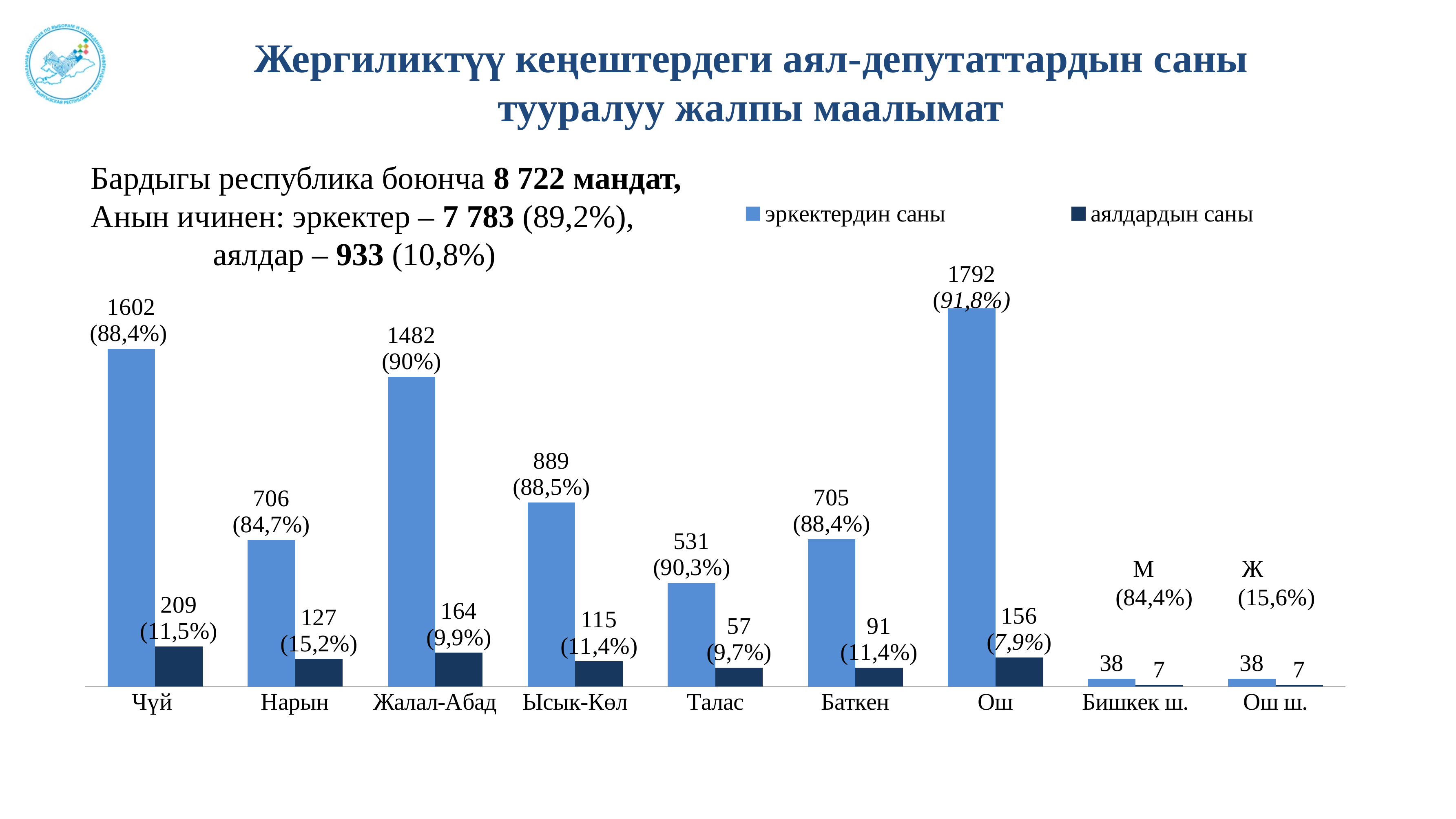
What percentage is shown next to the "эркектердин саны" value for Талас? 90,3% Which category has the highest value for "эркектердин саны"? Ош What are the two series names listed in the legend? эркектердин саны, аялдардын саны What kind of chart is shown on the slide? bar chart Which is larger, the "эркектердин саны" value for Нарын or for Баткен? Нарын Which category has the highest value for "аялдардын саны"? Чүй What is the value of "эркектердин саны" for Чүй? 1602 How many categories are shown on the x axis of the chart? 9 How many series does the legend list? 2 What is the value of "аялдардын саны" for Нарын? 127 What is the value of "аялдардын саны" for Ош? 156 What is the difference between the "эркектердин саны" values for Ош and Чүй? 190